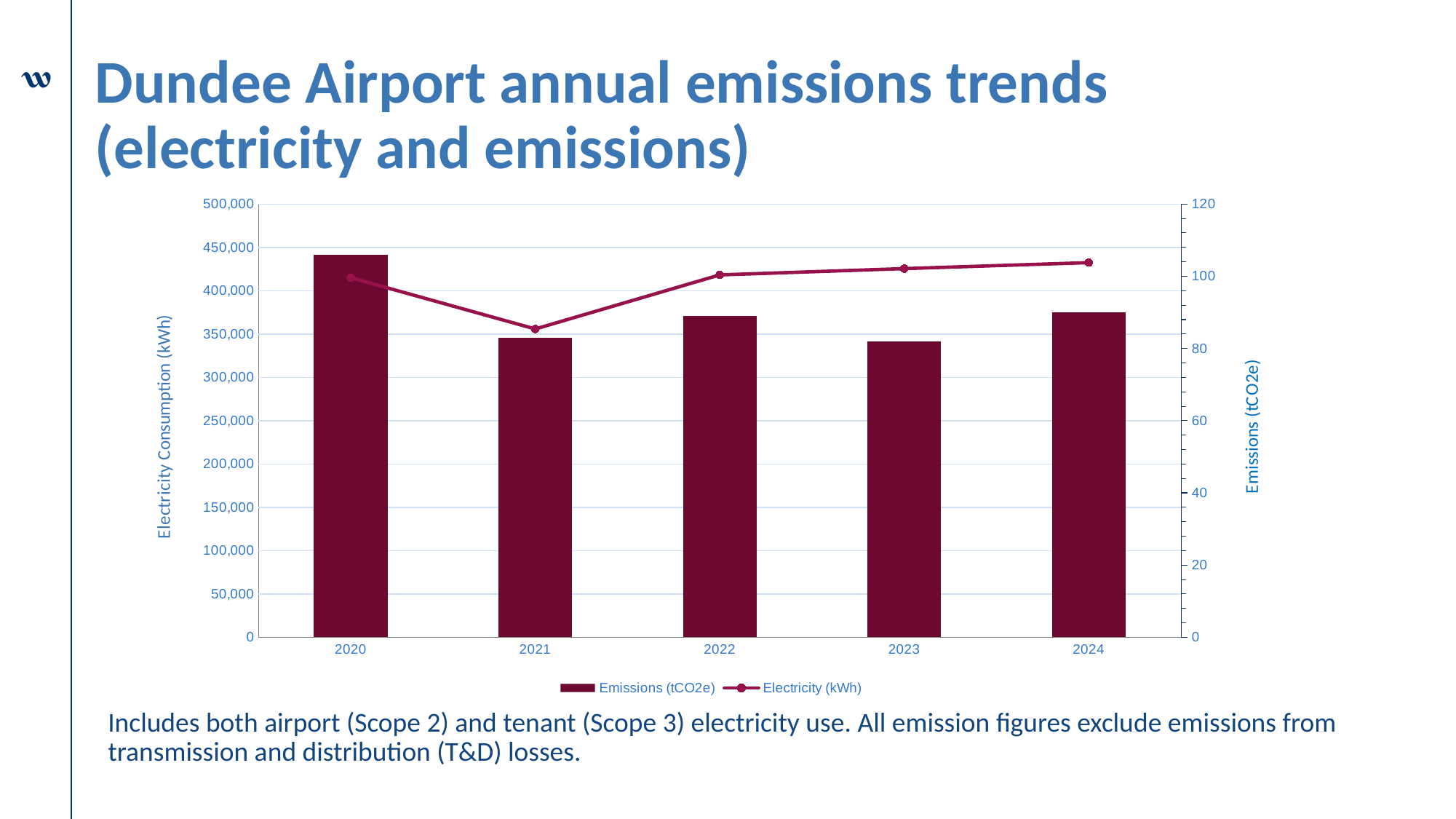
Which year has the tallest bar in the chart? 2020 How many years are shown on the x axis of the chart? 5 In which year does the line reach its lowest point? 2021 What is the title of the left vertical axis of the chart? Electricity Consumption (kWh) How many series does the chart legend list? 2 Does the line rise or fall from 2021 to 2024? It rises Which bar is taller, 2020 or 2021? 2020 What kind of chart is shown on the slide? A combined bar and line chart